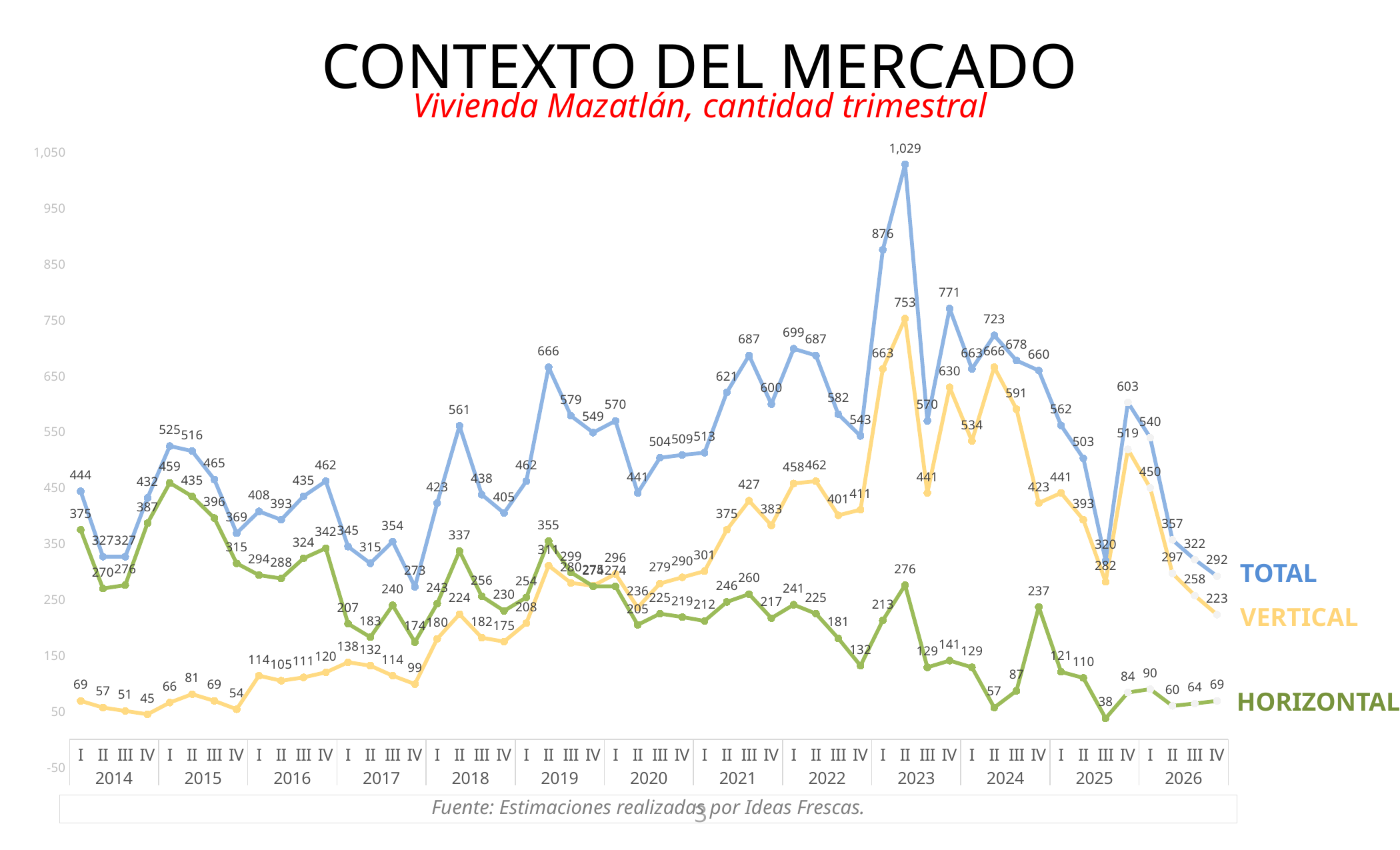
What is the VERTICAL value for quarter IV of 2026? 223 What kind of chart is shown on the slide? line chart What is the difference between the TOTAL values for quarter II of 2023 and quarter I of 2023? 153 In quarter I of 2024, which is larger, VERTICAL or HORIZONTAL? VERTICAL What is the TOTAL value for quarter I of 2014? 444 What is the highest value of the TOTAL series? 1,029 In which quarter and year does the TOTAL series reach its highest value? II 2023 How many series does the chart show? 3 What is the lowest value of the HORIZONTAL series? 38 Does the TOTAL series rise or fall from quarter IV of 2025 to quarter IV of 2026? fall What is the HORIZONTAL value for quarter III of 2025? 38 How many years are shown on the x axis? 13